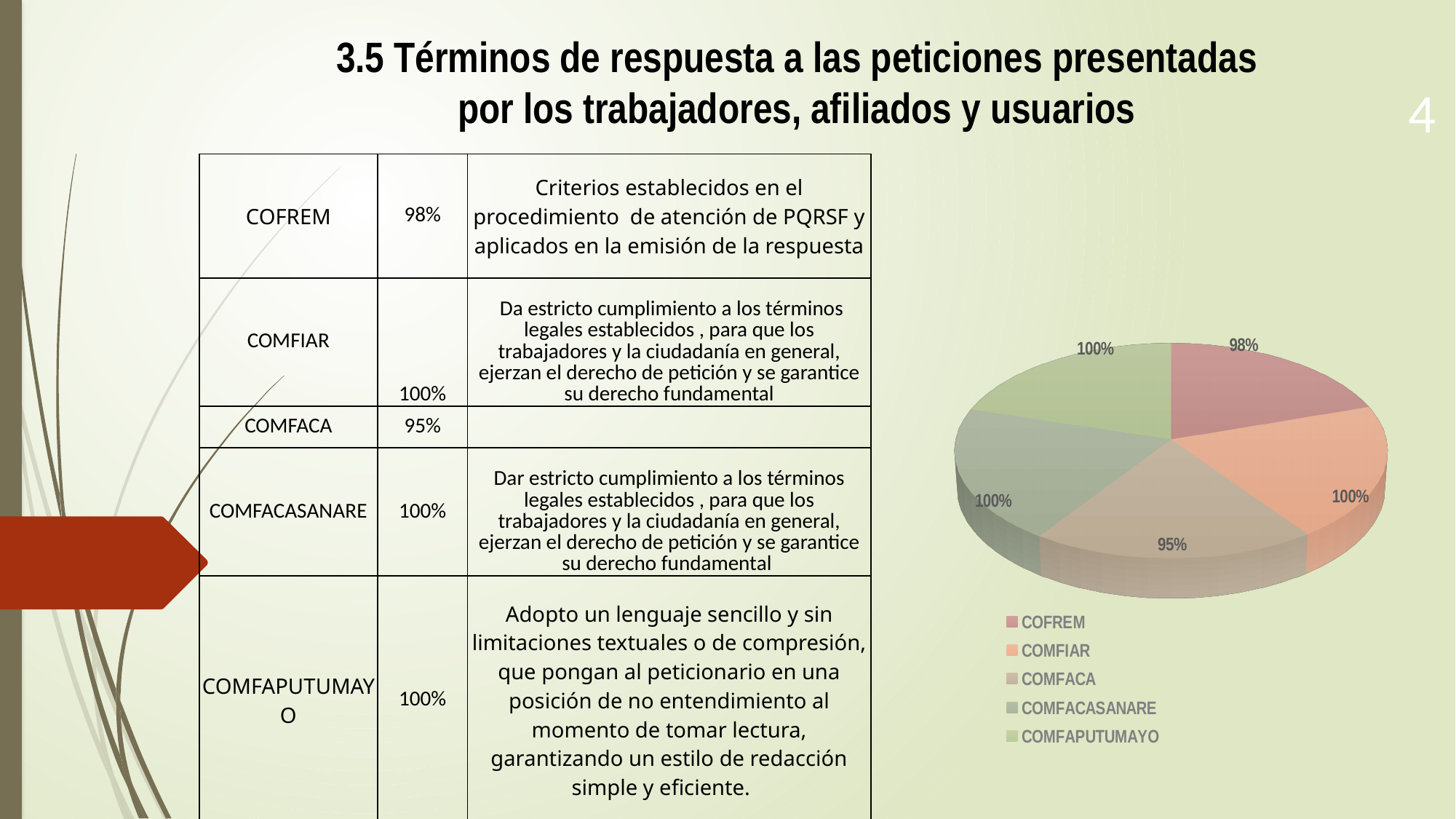
What kind of chart is shown on the slide? Pie chart What value is shown for COMFIAR in the pie chart? 100% Which has a larger value in the pie chart, COFREM or COMFACA? COFREM What value is shown for COFREM in the pie chart? 98% What value is shown for COMFACASANARE in the pie chart? 100% What is the difference between the values for COFREM and COMFACA in the pie chart? 3% How many entries does the legend of the pie chart list? 5 What value is shown for COMFACA in the pie chart? 95% How many slices does the pie chart have? 5 What value is shown for COMFAPUTUMAYO in the pie chart? 100% Which has a larger value in the pie chart, COMFIAR or COMFACA? COMFIAR Which category has the lowest value in the pie chart? COMFACA